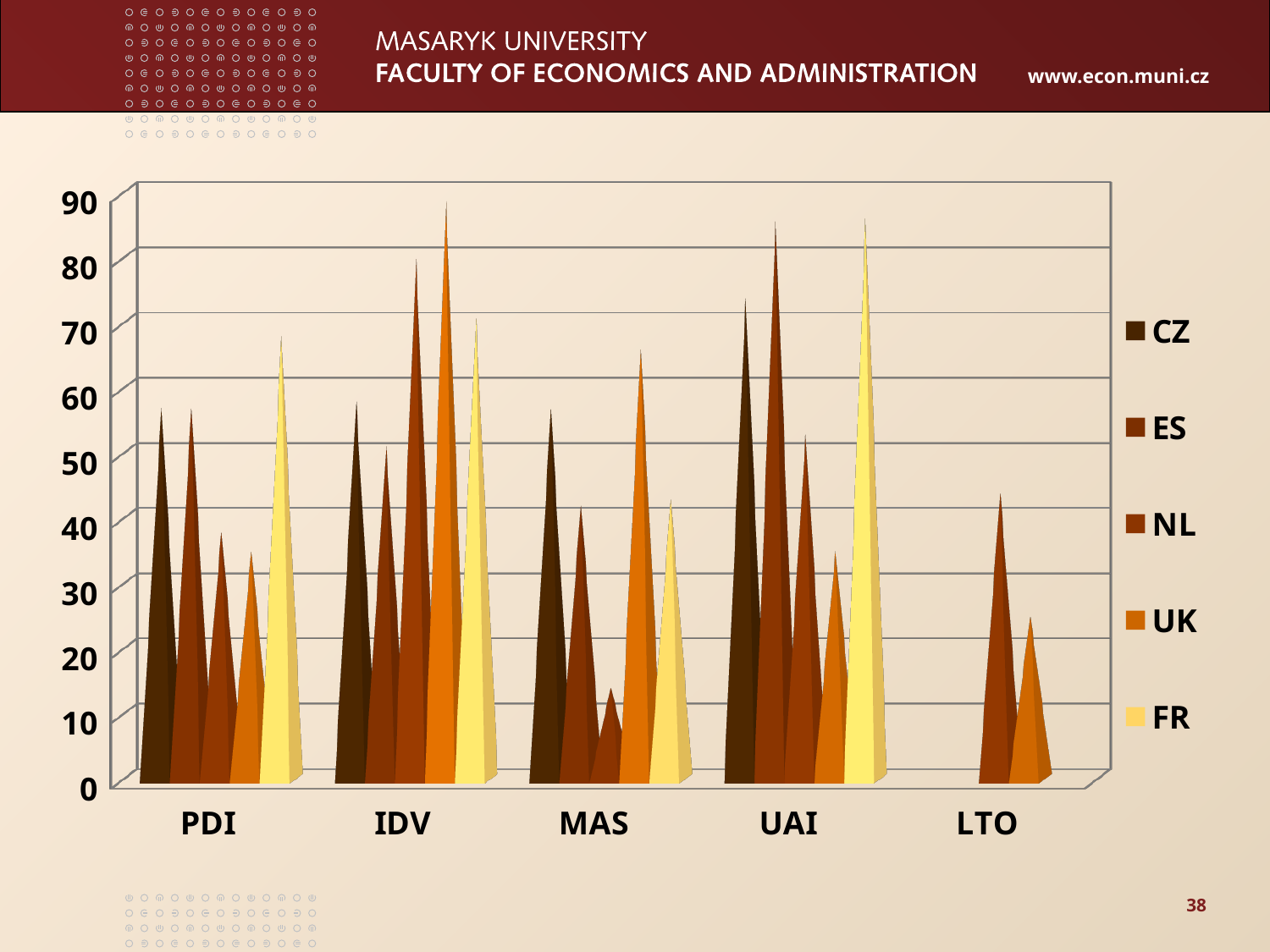
What kind of chart is shown on the slide? bar chart Is the value for UK in the LTO category greater or less than 30? less Is the value for FR in the PDI category greater or less than 60? greater In the PDI category, which is larger: the value for FR or the value for NL? FR Which series has the lowest value in the UAI category? UK Is the value for NL in the MAS category greater or less than 20? less Which series has the highest value in the IDV category? UK How many bars are plotted in the LTO category? 2 How many categories are shown on the x axis of the chart? 5 How many series does the chart's legend list? 5 Which series has the lowest value in the MAS category? NL Which series has the highest value in the PDI category? FR